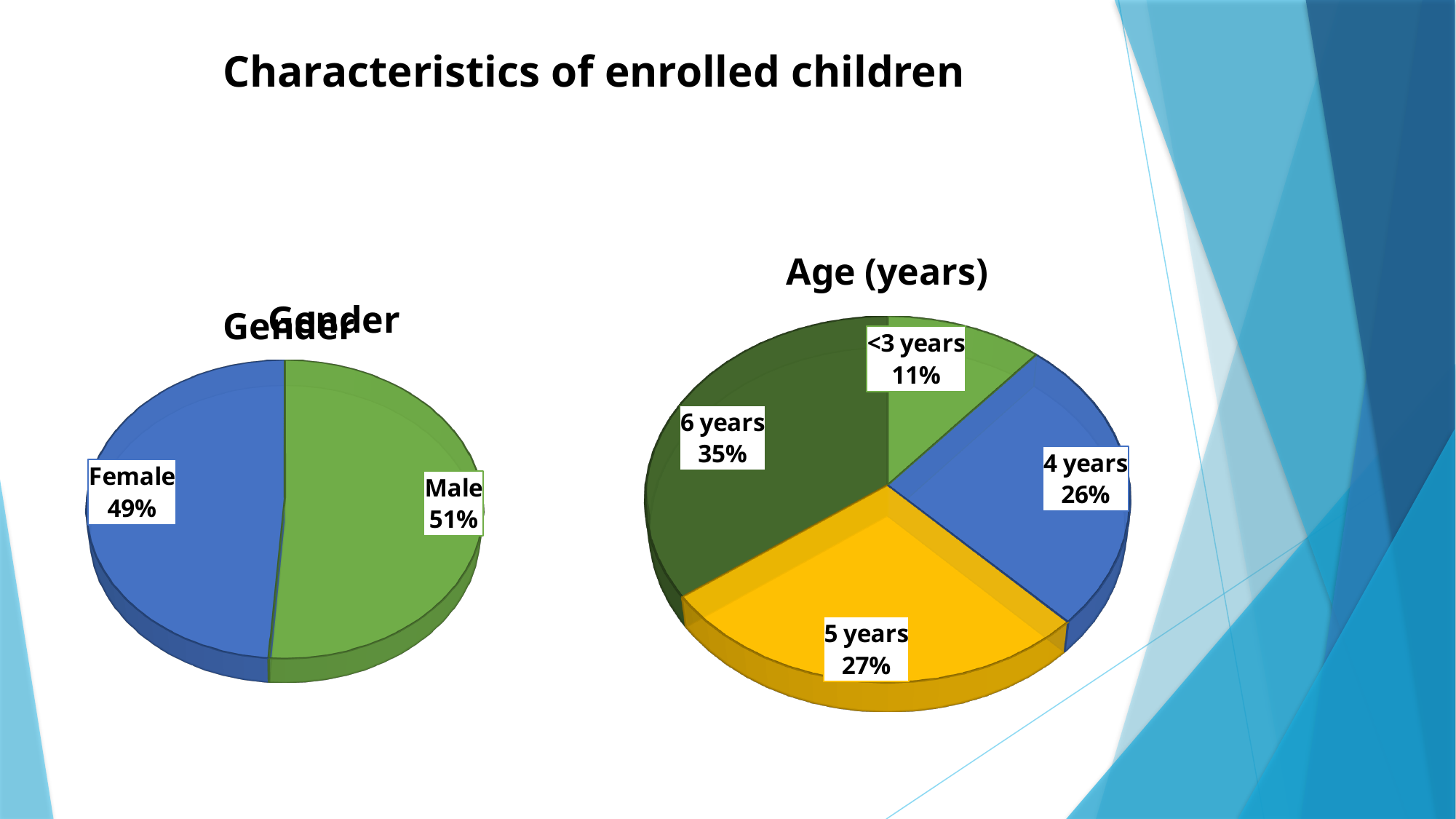
What kind of chart is the Gender chart? Pie chart In the Age (years) chart, which age group has the largest share? 6 years In the Age (years) chart, what percentage of enrolled children are under 3 years old? 11% In the Age (years) chart, what is the difference in percentage points between the 6 years and 4 years groups? 9% In the Age (years) chart, how many age groups are shown? 4 In the Gender chart, which category has the larger share, Female or Male? Male In the Gender chart, what is the difference in percentage points between Male and Female? 2% In the Gender chart, what percentage of enrolled children are Male? 51% In the Gender chart, what percentage of enrolled children are Female? 49% In the Age (years) chart, what percentage of enrolled children are 6 years old? 35% In the Age (years) chart, what percentage of enrolled children are 5 years old? 27% In the Age (years) chart, which age group has the smallest share? <3 years